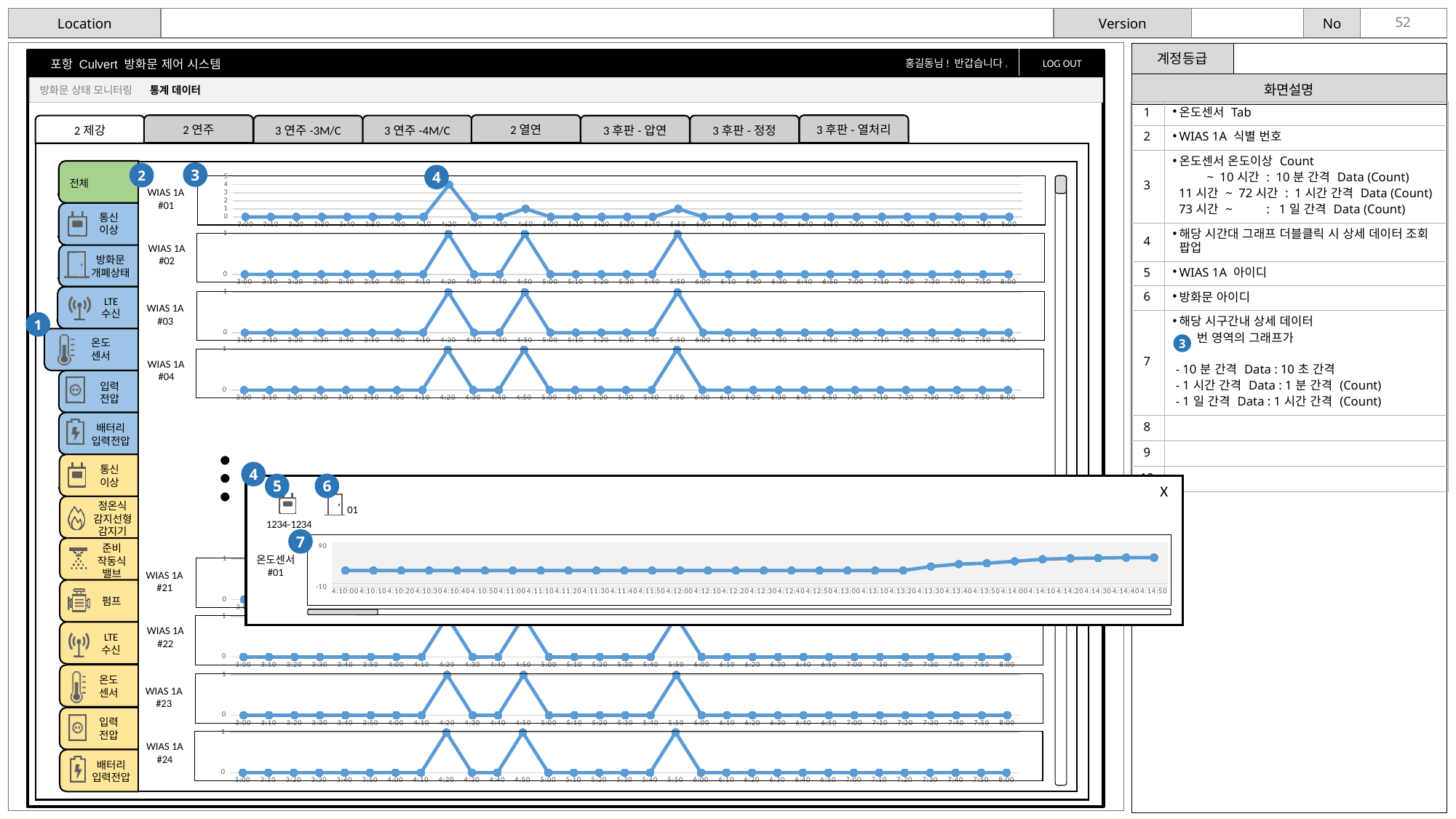
What kind of chart is the WIAS 1A #01 chart? line chart What is the last time label on the x axis of the WIAS 1A #24 chart? 8:00 In the WIAS 1A #01 chart, is the value at 4:20 greater or less than 3? greater In the popup chart labelled 온도센서 #01, what is the first time label on the x axis? 4:10:00 What is the first time label on the x axis of the WIAS 1A #03 chart? 3:00 In the popup chart labelled 온도센서 #01, what is the highest value shown on the y axis? 90 In the popup chart labelled 온도센서 #01, what is the lowest value shown on the y axis? -10 In the WIAS 1A #01 chart, which is larger, the value at 4:20 or the value at 4:50? 4:20 In the WIAS 1A #01 chart, at which time does the line reach its highest value? 4:20 In the WIAS 1A #02 chart, at which three times does the line peak? 4:20, 4:50, 5:50 In the popup chart labelled 온도센서 #01, does the line rise or fall toward the right end of the x axis? rise In the WIAS 1A #02 chart, what is the value at 3:00? 0